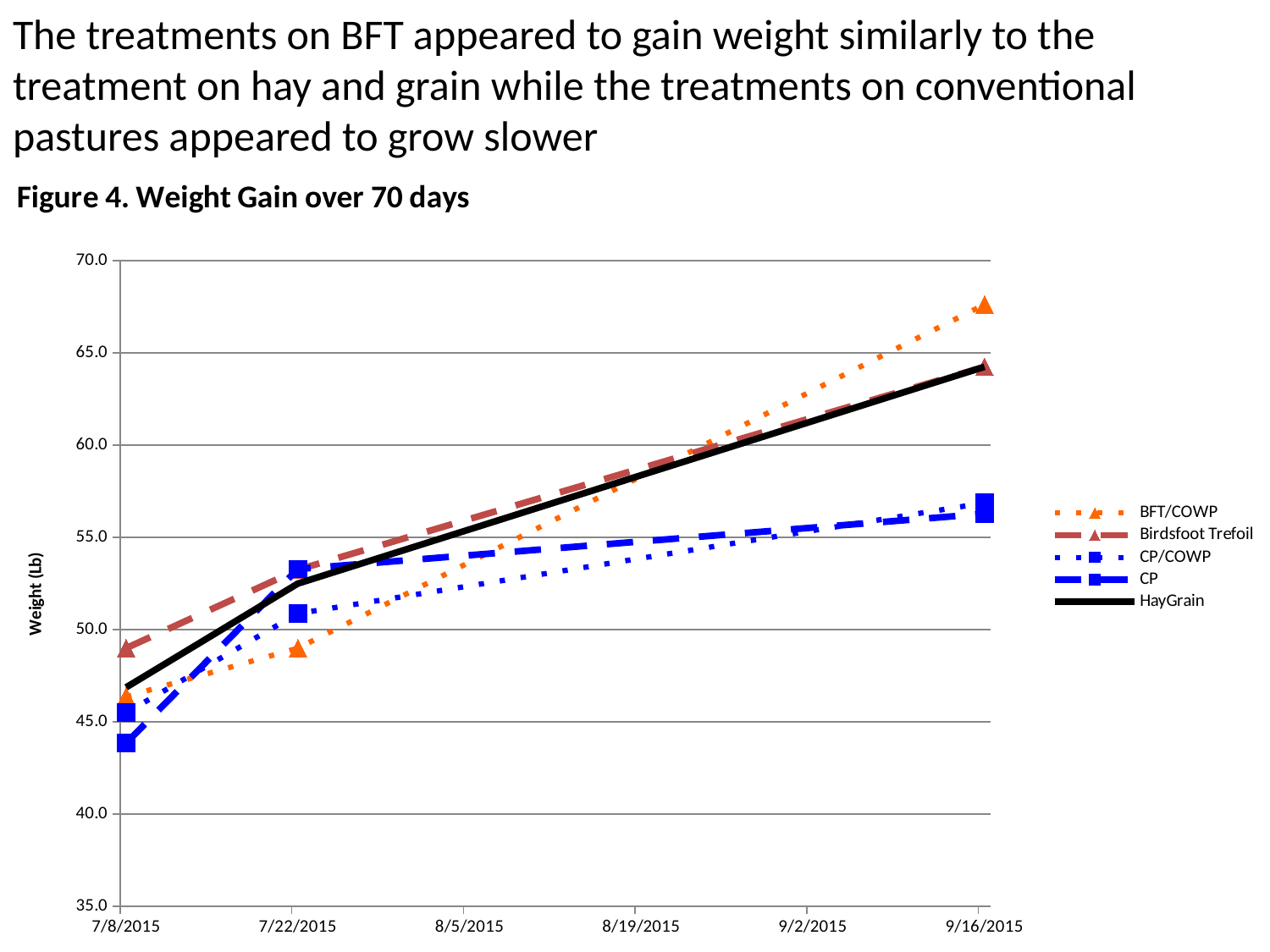
Which series has the highest weight on 7/8/2015? Birdsfoot Trefoil How many series does the legend list? 5 Does the weight for the HayGrain series rise or fall from 7/8/2015 to 9/16/2015? rise On 9/16/2015, which is larger: the weight for BFT/COWP or for HayGrain? BFT/COWP How many data points are plotted for the BFT/COWP series? 3 Is the weight for CP/COWP on 9/16/2015 greater or less than 55.0? greater Is the weight for BFT/COWP on 9/16/2015 greater or less than 65.0? greater What is the label on the vertical axis of the chart? Weight (Lb) Which series has the lowest weight on 7/8/2015? CP What kind of chart is shown in Figure 4? line chart Which series has the highest weight on 9/16/2015? BFT/COWP Is the weight for CP on 7/8/2015 greater or less than 45.0? less